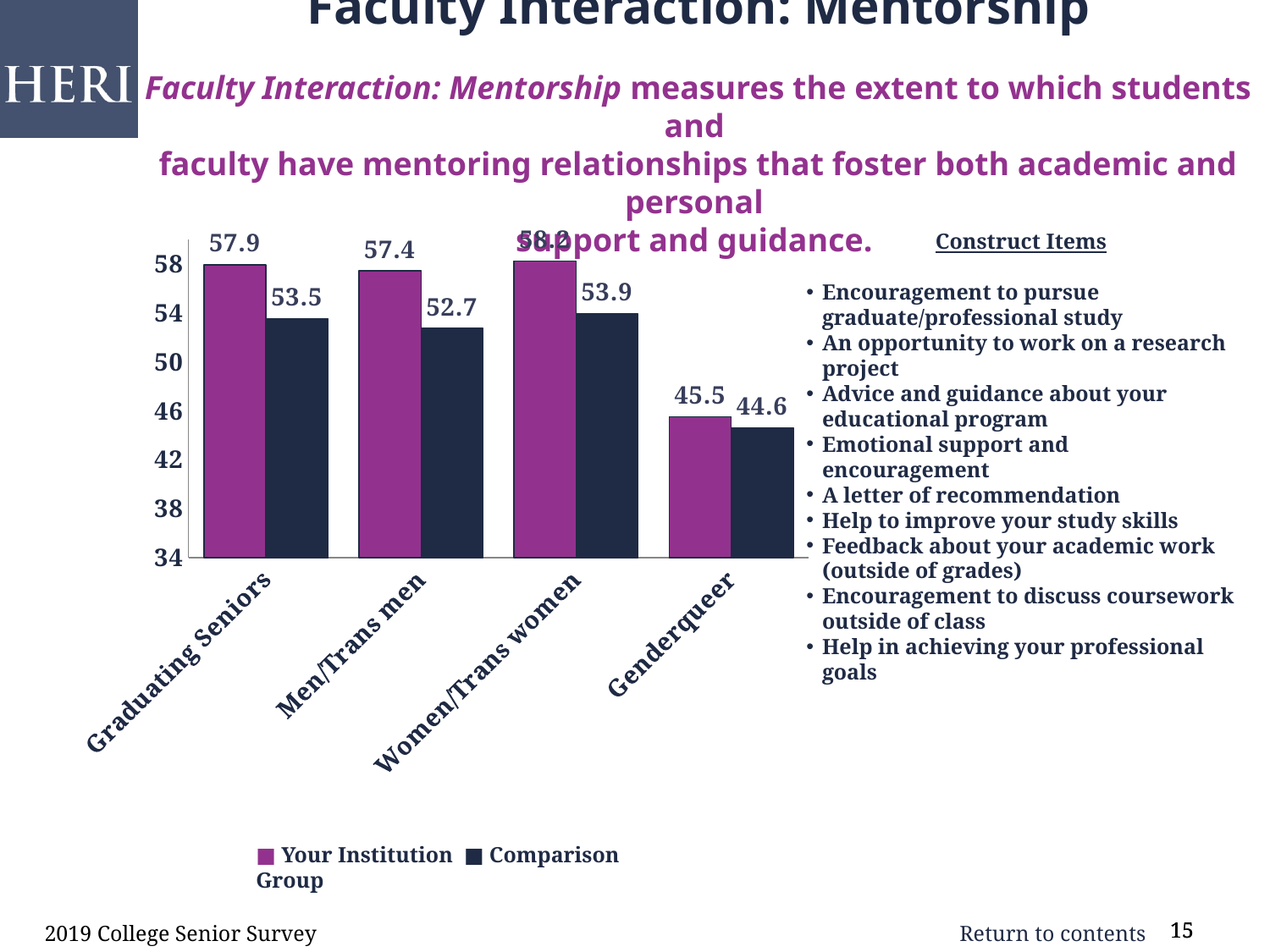
Which category has the lowest Comparison Group value? Genderqueer What is the Your Institution value for Graduating Seniors? 57.9 How many series does the legend list? 2 What is the Your Institution value for Genderqueer? 45.5 What kind of chart is shown on the slide? bar chart Is the Comparison Group value for Genderqueer greater or less than 46? less What is the difference between the Your Institution and Comparison Group values for Men/Trans men? 4.7 What is the Comparison Group value for Men/Trans men? 52.7 How many categories are shown on the x axis? 4 What is the Comparison Group value for Women/Trans women? 53.9 Which is larger for Genderqueer: the Your Institution value or the Comparison Group value? Your Institution What is the difference between the Your Institution and Comparison Group values for Graduating Seniors? 4.4